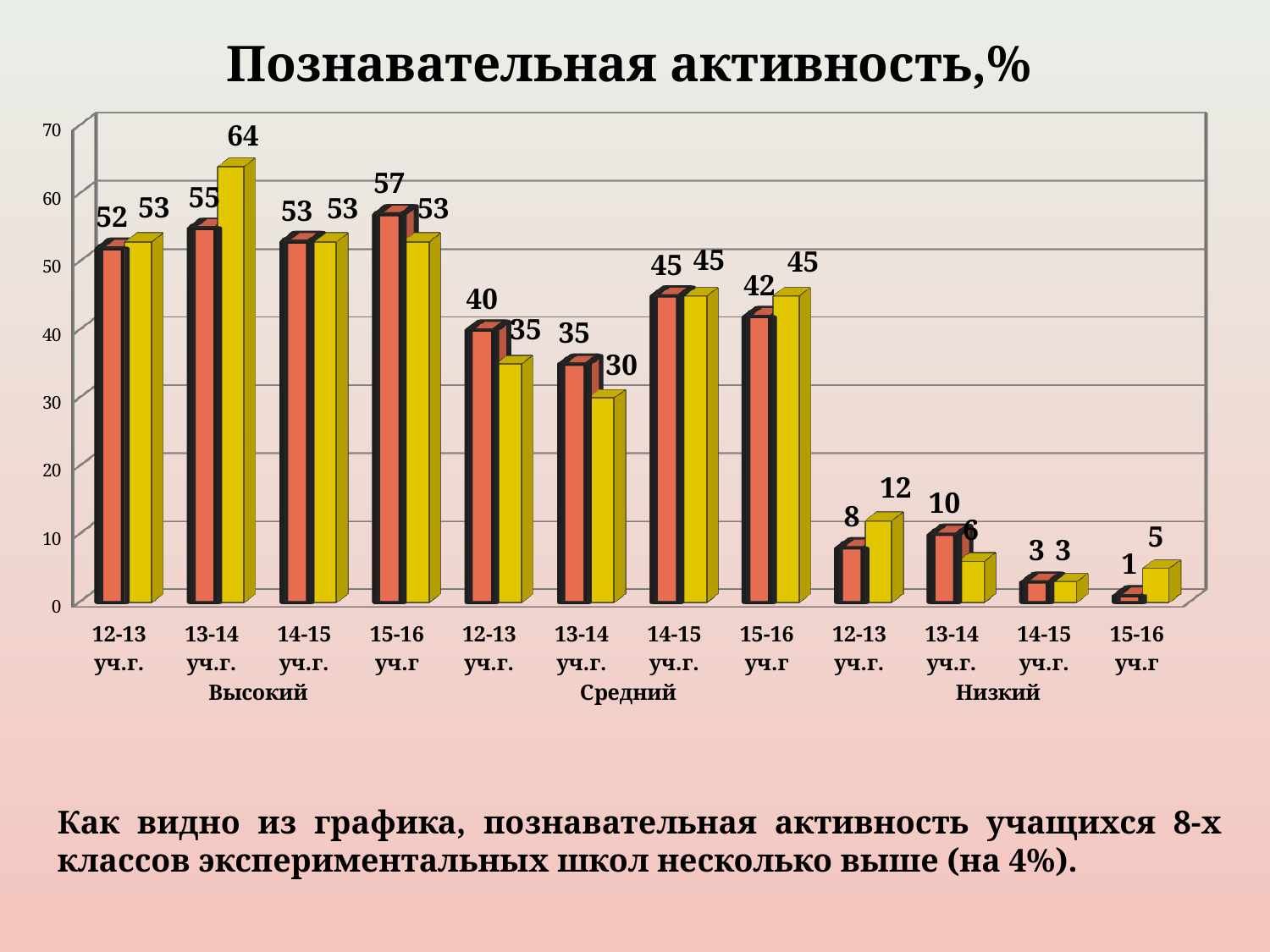
Which bar has the lowest value in the whole chart? orange bar for 15-16 уч.г in the Низкий group (1) How many category groups (school years) are shown along the x axis? 12 What is the value of the orange bar for 15-16 уч.г in the Низкий group? 1 Which bar has the highest value in the whole chart? yellow bar for 13-14 уч.г. in the Высокий group (64) What is the value of the yellow bar for 13-14 уч.г. in the Средний group? 30 In the Средний group for 12-13 уч.г., which bar is larger, the orange or the yellow one? orange What is the difference between the yellow and orange bars for 13-14 уч.г. in the Высокий group? 9 What type of chart is shown on the slide? bar chart What is the value of the orange bar for 15-16 уч.г in the Высокий group? 57 What is the title of the chart? Познавательная активность,% What is the difference between the yellow bars for 12-13 уч.г. and 13-14 уч.г. in the Низкий group? 6 What is the value of the yellow bar for 13-14 уч.г. in the Высокий group? 64